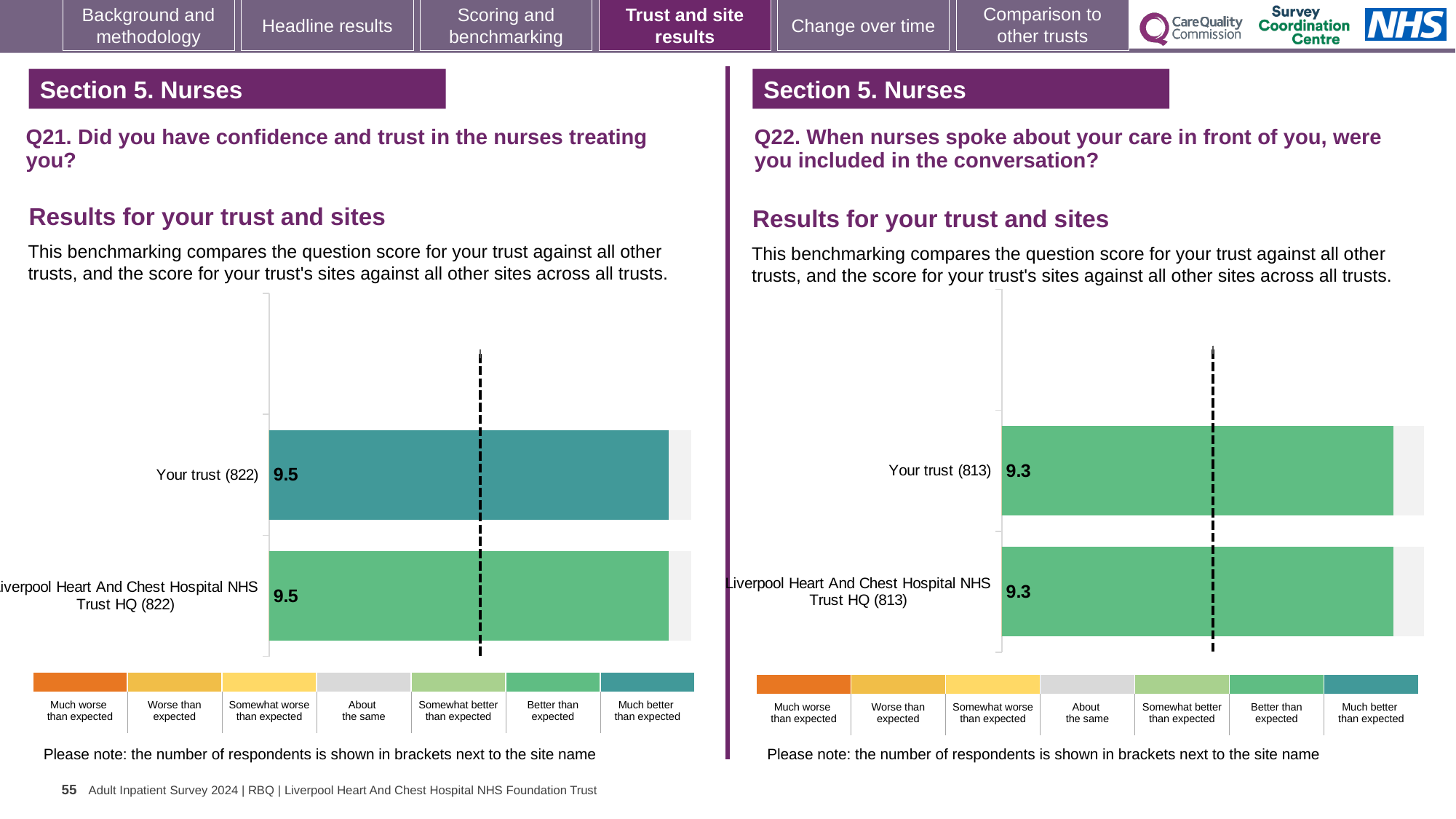
On the Q21 chart (left), how many respondents are shown in brackets for Your trust? 822 On the Q21 chart (left), what is the score for Liverpool Heart And Chest Hospital NHS Trust HQ (822)? 9.5 On the Q21 chart (left), what is the difference between the score for Your trust and the score for Liverpool Heart And Chest Hospital NHS Trust HQ? 0 What type of chart is used for the Q21 results (left)? Bar chart On the Q22 chart (right), how many respondents are shown in brackets for Your trust? 813 On the Q22 chart (right), what is the difference between the score for Your trust and the score for Liverpool Heart And Chest Hospital NHS Trust HQ? 0 On the Q21 chart (left), what is the score for Your trust (822)? 9.5 Is the Your trust score on the Q21 chart (left) larger or smaller than the Your trust score on the Q22 chart (right)? Larger On the Q22 chart (right), what is the score for Your trust (813)? 9.3 How many bars are plotted on the Q22 chart (right)? 2 On the Q22 chart (right), what is the score for Liverpool Heart And Chest Hospital NHS Trust HQ (813)? 9.3 How many bars are plotted on the Q21 chart (left)? 2